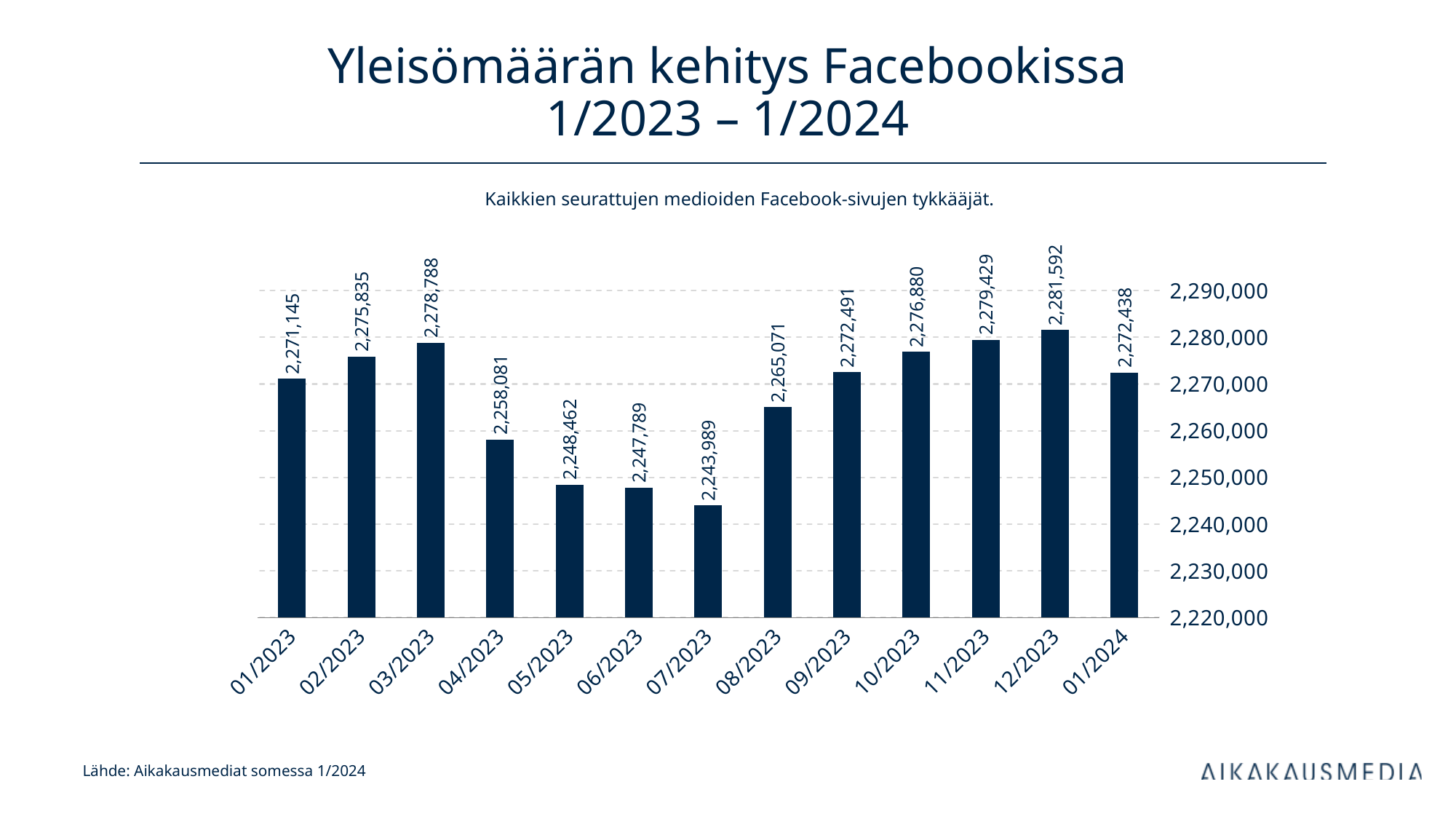
Is the value for 05/2023 greater or less than 2,250,000? less What is the difference between the values for 12/2023 and 07/2023? 37,603 What is the value for 07/2023? 2,243,989 Do the values rise or fall from 03/2023 to 07/2023? fall Which month has the highest value? 12/2023 What is the difference between the values for 01/2024 and 01/2023? 1,293 What is the value for 03/2023? 2,278,788 Which is larger, the value for 02/2023 or the value for 09/2023? 02/2023 How many months are shown on the x axis? 13 Which month has the lowest value? 07/2023 What kind of chart is shown on the slide? bar chart What is the value for 01/2024? 2,272,438